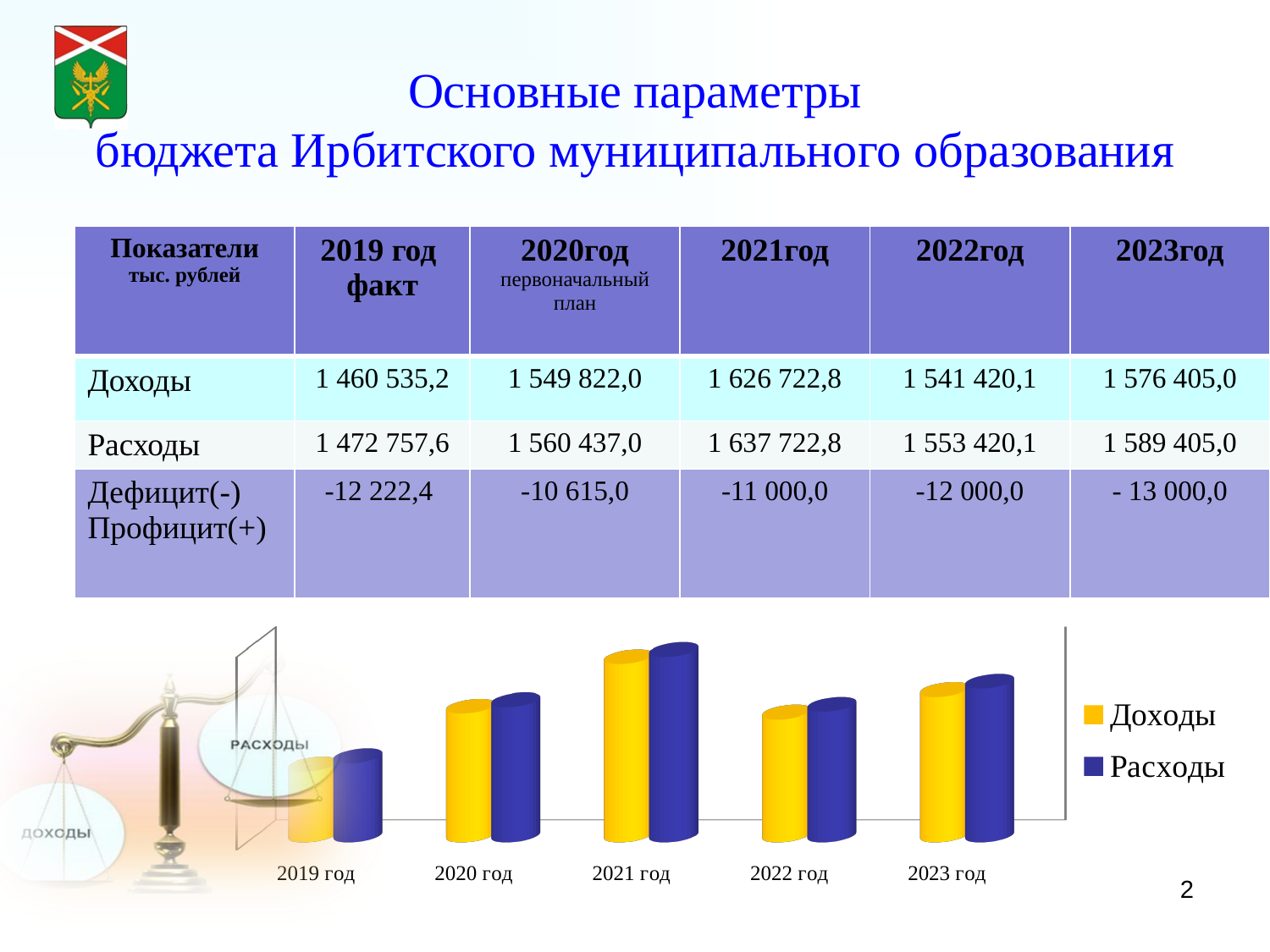
Which year has the highest Доходы bar in the chart? 2021 год How many year categories are plotted along the x axis of the chart? 5 Do the Доходы bars rise or fall from 2019 год to 2021 год? rise What is the difference between Доходы for 2021 год and Доходы for 2019 год, using the values printed on the slide? 166 187,6 Is the Расходы bar larger for 2019 год or for 2020 год? 2020 год According to the slide, what is the value of Расходы for 2023 год (тыс. рублей)? 1 589 405,0 Is the Доходы bar larger for 2021 год or for 2022 год? 2021 год What kind of chart is shown at the bottom of the slide? bar chart According to the slide, what is the value of Доходы for 2021 год (тыс. рублей)? 1 626 722,8 How many series does the chart legend list? 2 Which colour represents the Расходы series in the chart? blue Which year has the lowest Расходы bar in the chart? 2019 год